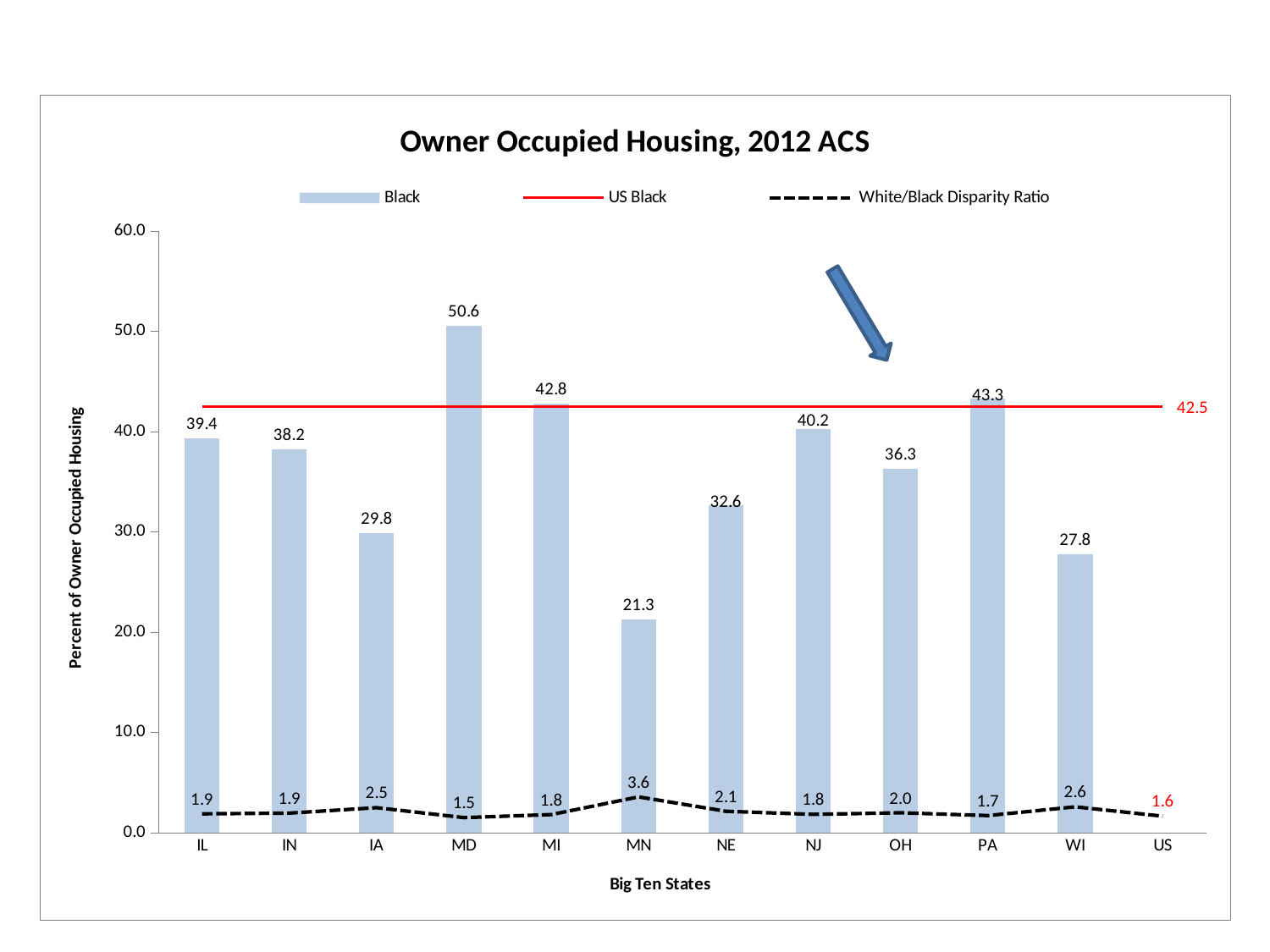
What is the White/Black Disparity Ratio for MN? 3.6 What is the title of the chart? Owner Occupied Housing, 2012 ACS Which state has the lowest Black owner occupied housing percentage? MN How many states are shown on the x axis, excluding US? 11 What is the White/Black Disparity Ratio for the US? 1.6 How many series does the legend list? 3 What is the value of the US Black line? 42.5 What kind of chart is used for the Black series? Bar chart Which state has the highest Black owner occupied housing percentage? MD Which has a higher Black owner occupied housing percentage, PA or NJ? PA What is the difference between the Black owner occupied housing percentages for MD and MN? 29.3 What is the Black owner occupied housing percentage for MD? 50.6